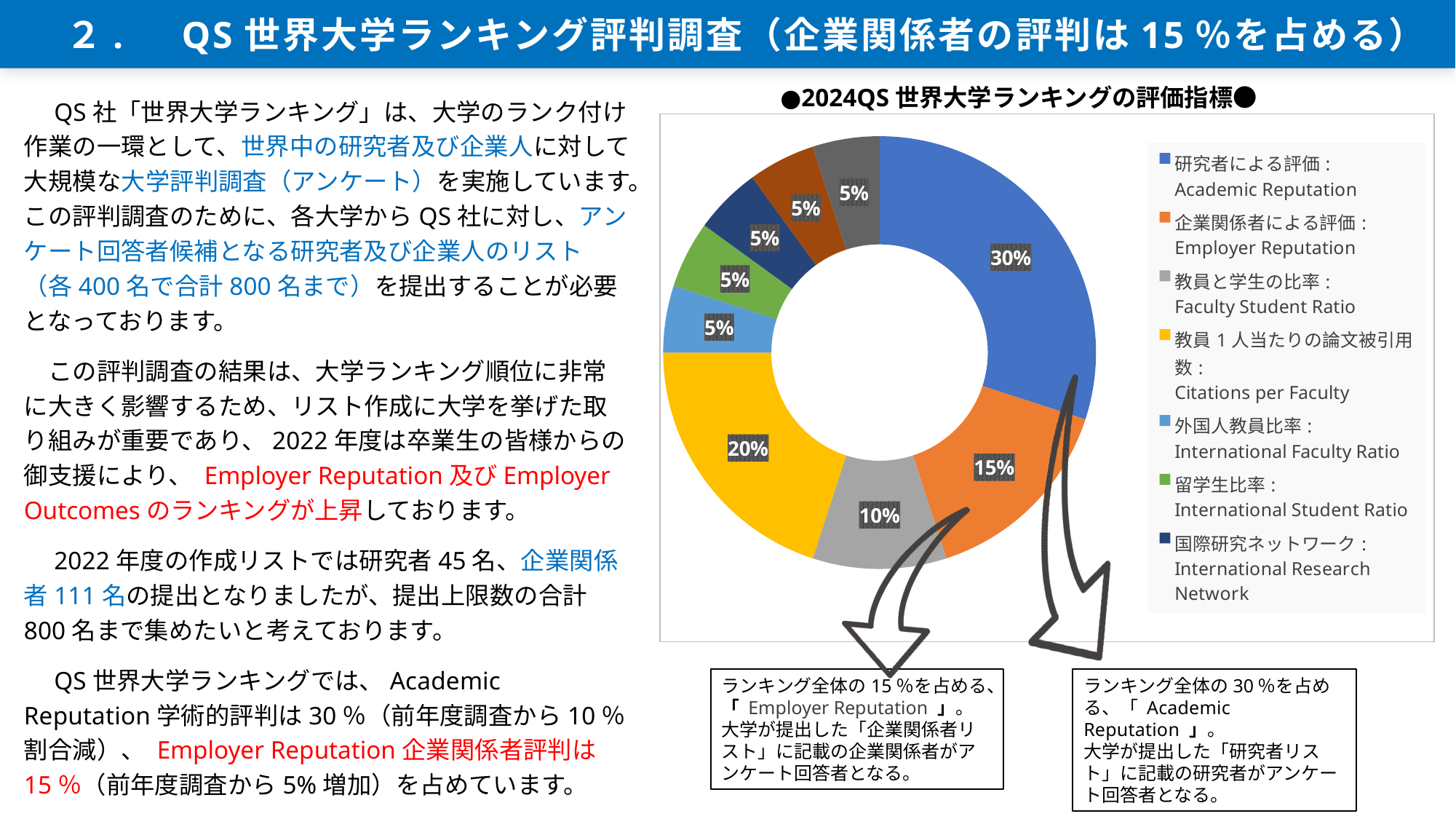
What is the difference between the Academic Reputation share and the Employer Reputation share? 15% What is the value for Faculty Student Ratio (教員と学生の比率)? 10% What is the value for Employer Reputation (企業関係者による評価)? 15% What type of chart is shown on the slide? Doughnut (pie) chart How many slices does the doughnut chart have? 9 What is the value for Academic Reputation (研究者による評価)? 30% Which is larger, the share for Citations per Faculty or the share for Employer Reputation? Citations per Faculty Which category has the largest share of the chart? Academic Reputation (研究者による評価) What is the value for International Student Ratio (留学生比率)? 5% What is the title of the chart? ●2024QS 世界大学ランキングの評価指標● How many entries does the legend list? 7 What is the value for Citations per Faculty (教員1人当たりの論文被引用数)? 20%